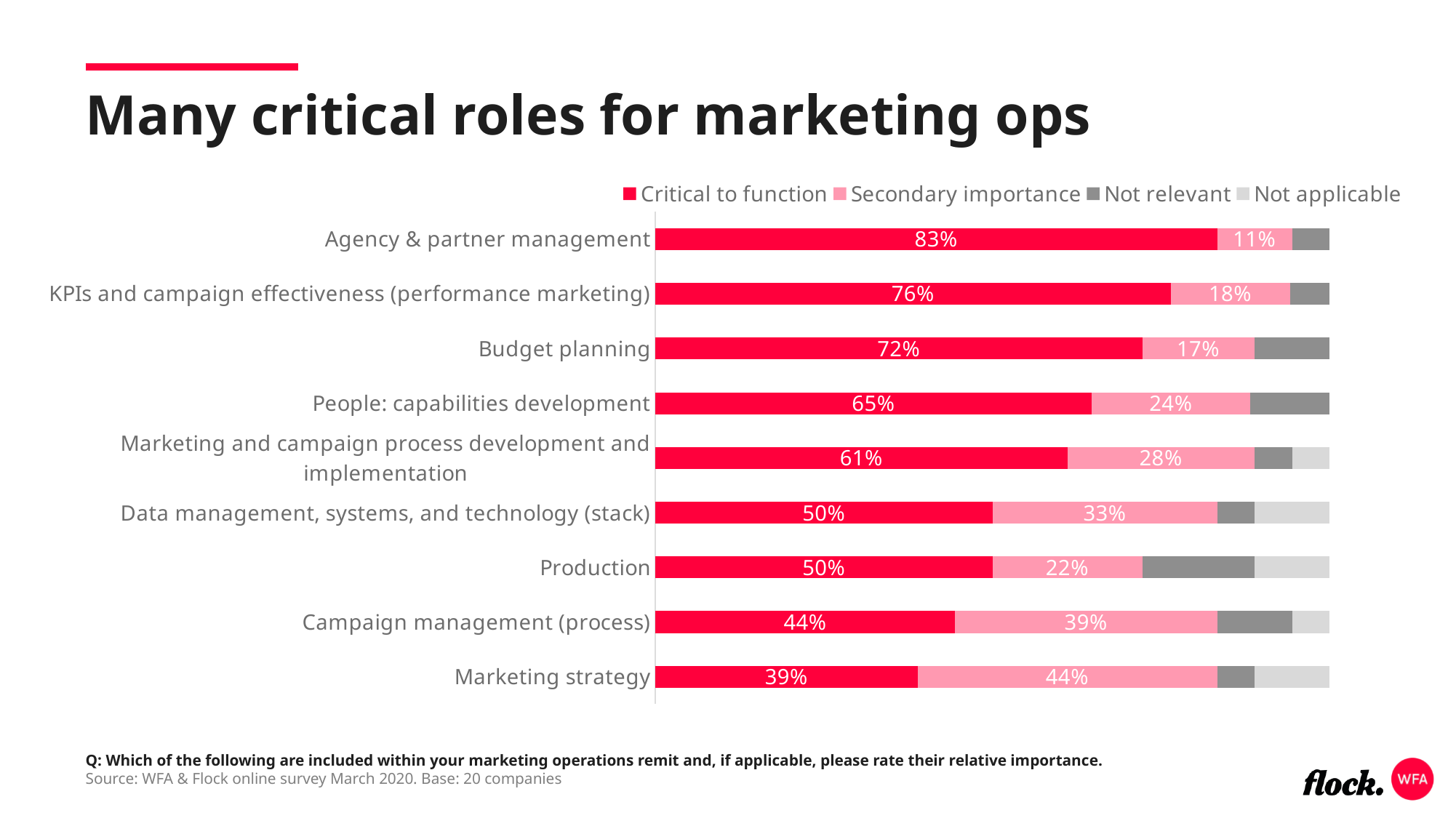
What is the difference between the Critical to function values for Budget planning and Production? 22% Which legend entry is shown in dark grey? Not relevant Which category has the highest Critical to function percentage? Agency & partner management Which has a larger Critical to function value: KPIs and campaign effectiveness (performance marketing) or People: capabilities development? KPIs and campaign effectiveness (performance marketing) What is the Secondary importance value for Campaign management (process)? 39% Which category has the lowest Critical to function percentage? Marketing strategy What is the Critical to function value for Marketing strategy? 39% Which category has the highest Secondary importance percentage? Marketing strategy What percentage of respondents rated Agency & partner management as critical to function? 83% How many series does the legend list? 4 How many categories are shown in the chart? 9 What kind of chart is shown on the slide? Stacked bar chart